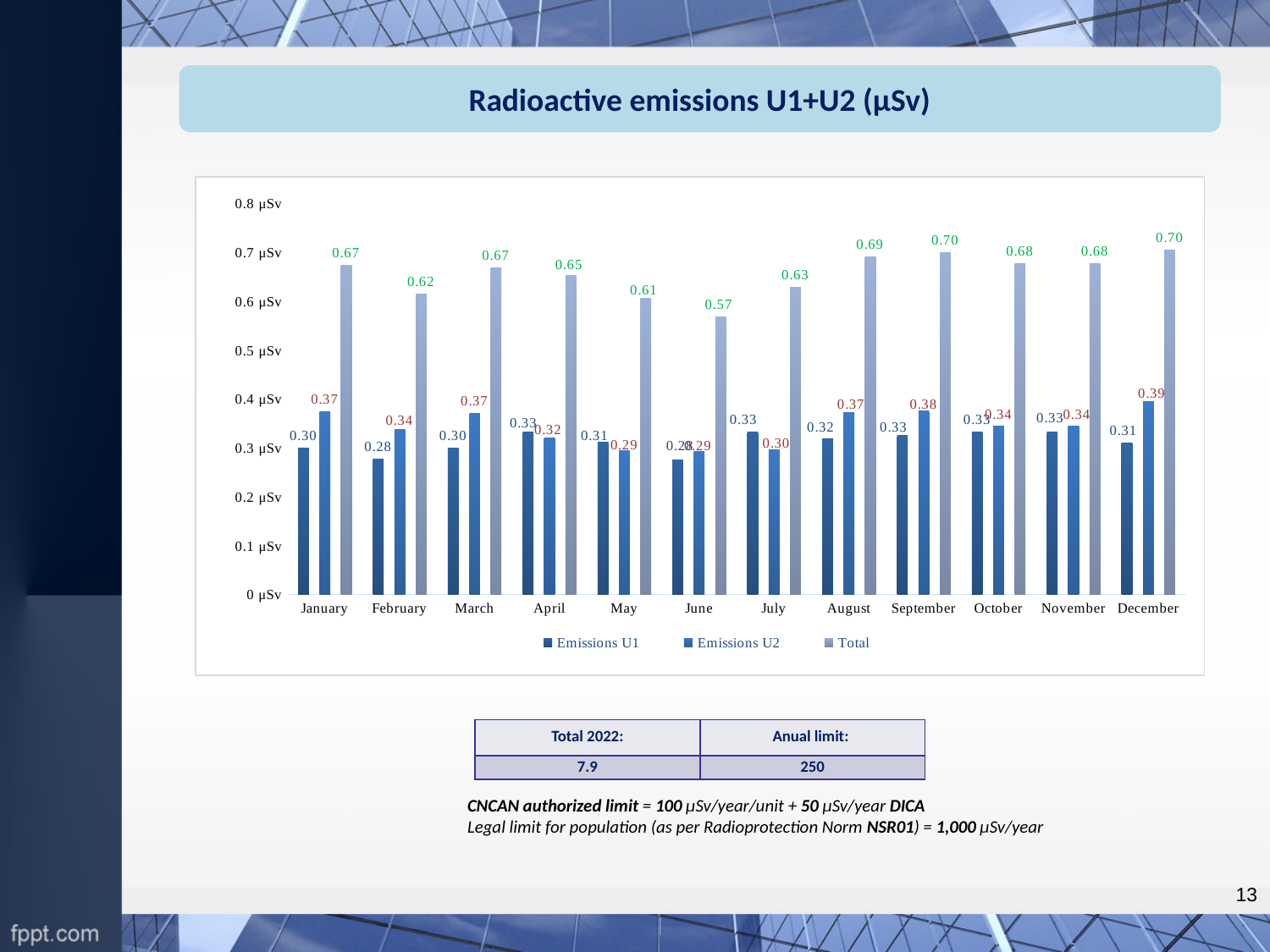
Is the Total value for May greater or less than 0.5 μSv? greater What is the Total value for August? 0.69 What is the Total value for June? 0.57 How many months are shown on the x axis? 12 What is the Emissions U2 value for December? 0.39 What is the difference between the Total values for September and June? 0.13 What kind of chart is shown on the slide? Bar chart How many series does the legend list? 3 Which month has the lowest Total value? June Which is larger in April, Emissions U1 or Emissions U2? Emissions U1 Which month has the highest Emissions U2 value? December What is the Emissions U1 value for February? 0.28